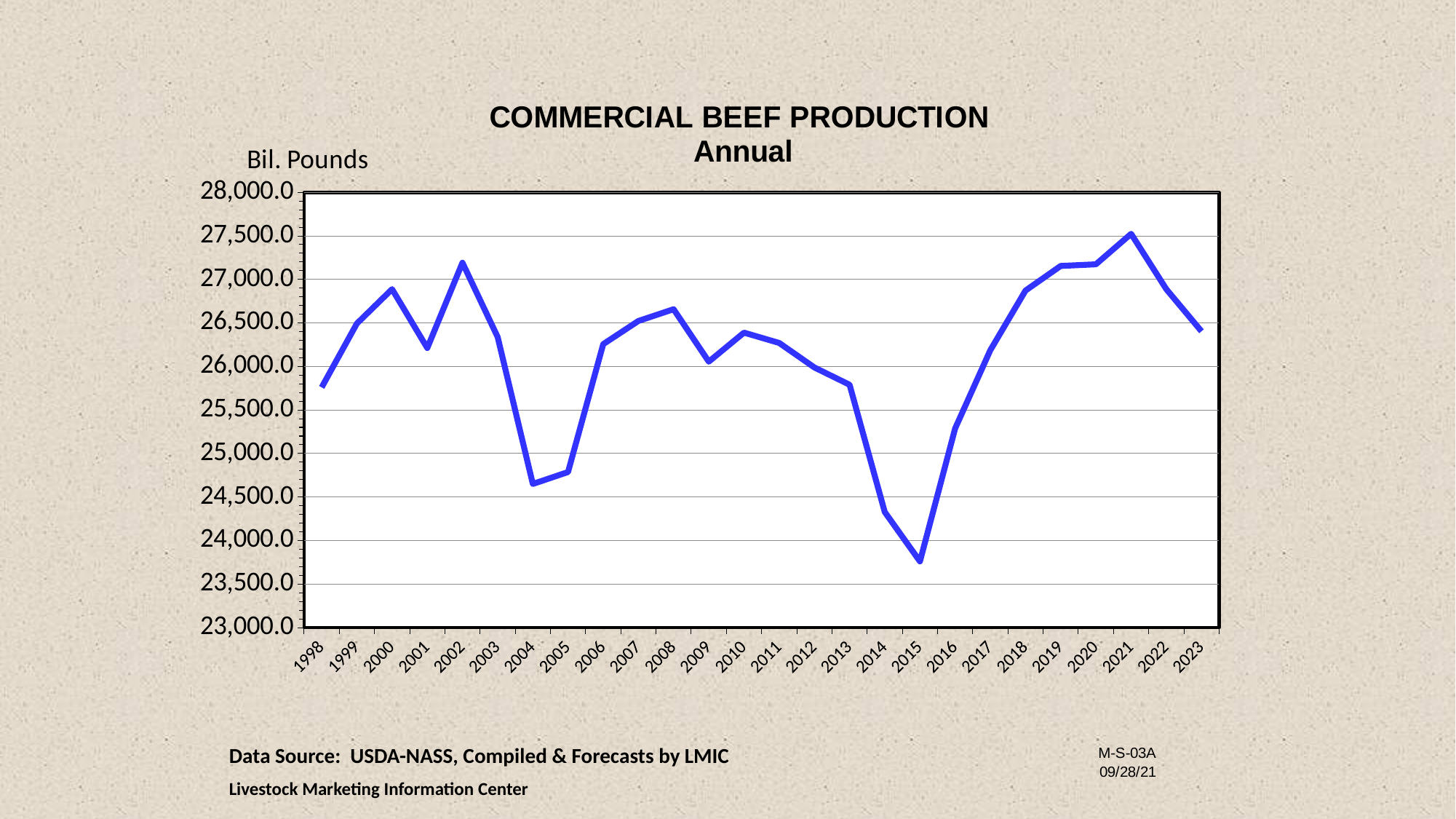
Is the value for 2004 greater or less than 25,000.0? less Which year has the larger value, 2000 or 2010? 2000 Is the value for 2021 greater or less than 27,000.0? greater Is the value for 1998 greater or less than 26,000.0? less What unit is shown on the y axis label? Bil. Pounds Do the values rise or fall from 2015 to 2021? rise Which year has the highest commercial beef production? 2021 Which year has the lowest commercial beef production? 2015 How many years are plotted along the x axis? 26 What kind of chart is shown on the slide? line chart Which year has the larger value, 2004 or 2015? 2004